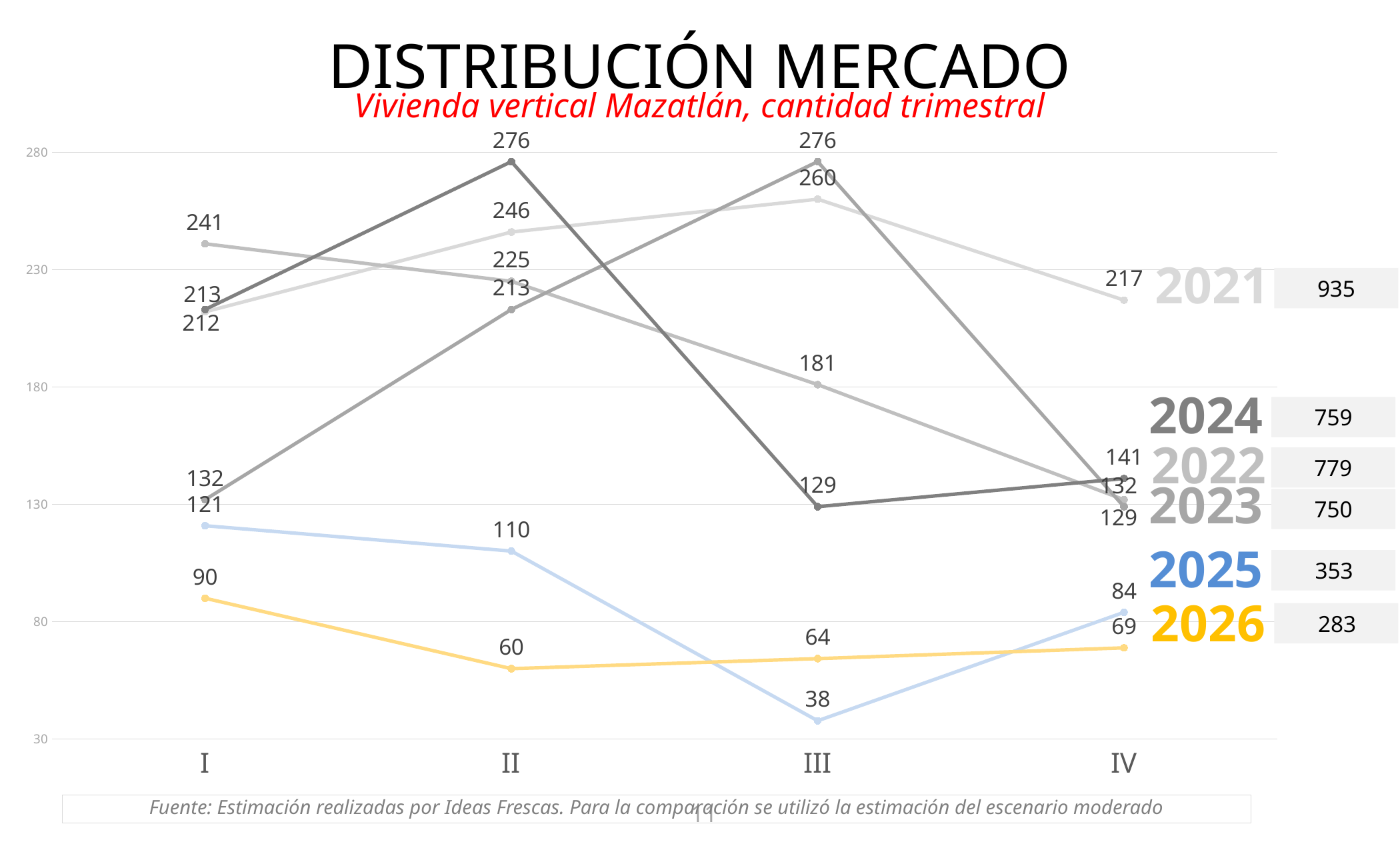
Does the 2026 series rise or fall from quarter II to quarter IV? rise Which year has the highest annual total shown on the right of the chart? 2021 What kind of chart is shown on the slide? line chart How many quarters are shown on the x axis? 4 What annual total is shown next to the 2021 label? 935 What is the value for the 2026 series in quarter I? 90 Which year has the lowest annual total shown on the right of the chart? 2026 In quarter I, which is larger: the 2025 value or the 2026 value? 2025 What is the value for the 2025 series in quarter III? 38 What is the value for the 2025 series in quarter IV? 84 How many year series are labelled on the chart? 6 What is the difference between the 2025 values in quarter I and quarter III? 83